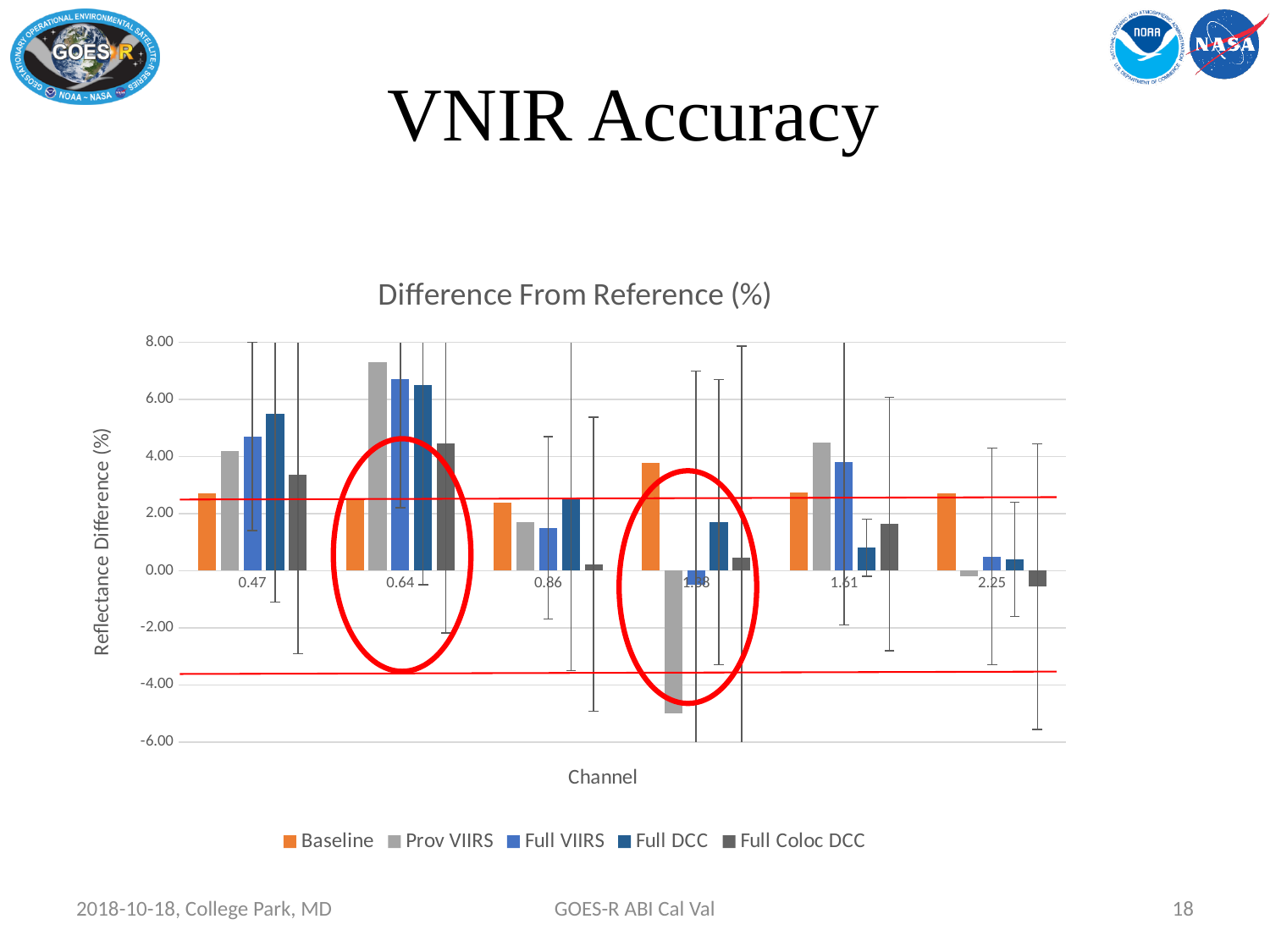
What is the title of the chart? Difference From Reference (%) How many channel categories are shown on the x axis? 6 For channel 0.86, which is larger: the Full DCC value or the Full VIIRS value? Full DCC Which series has the lowest bar for channel 0.47? Baseline Is the Prov VIIRS value for channel 0.64 greater or less than 6.00? greater How many series does the legend list? 5 What is the label of the y axis? Reflectance Difference (%) Which series has the highest bar for channel 0.64? Prov VIIRS Is the Full Coloc DCC value for channel 2.25 greater or less than 0.00? less Is the Prov VIIRS value for channel 1.61 greater or less than 4.00? greater What kind of chart is shown on the slide? bar chart